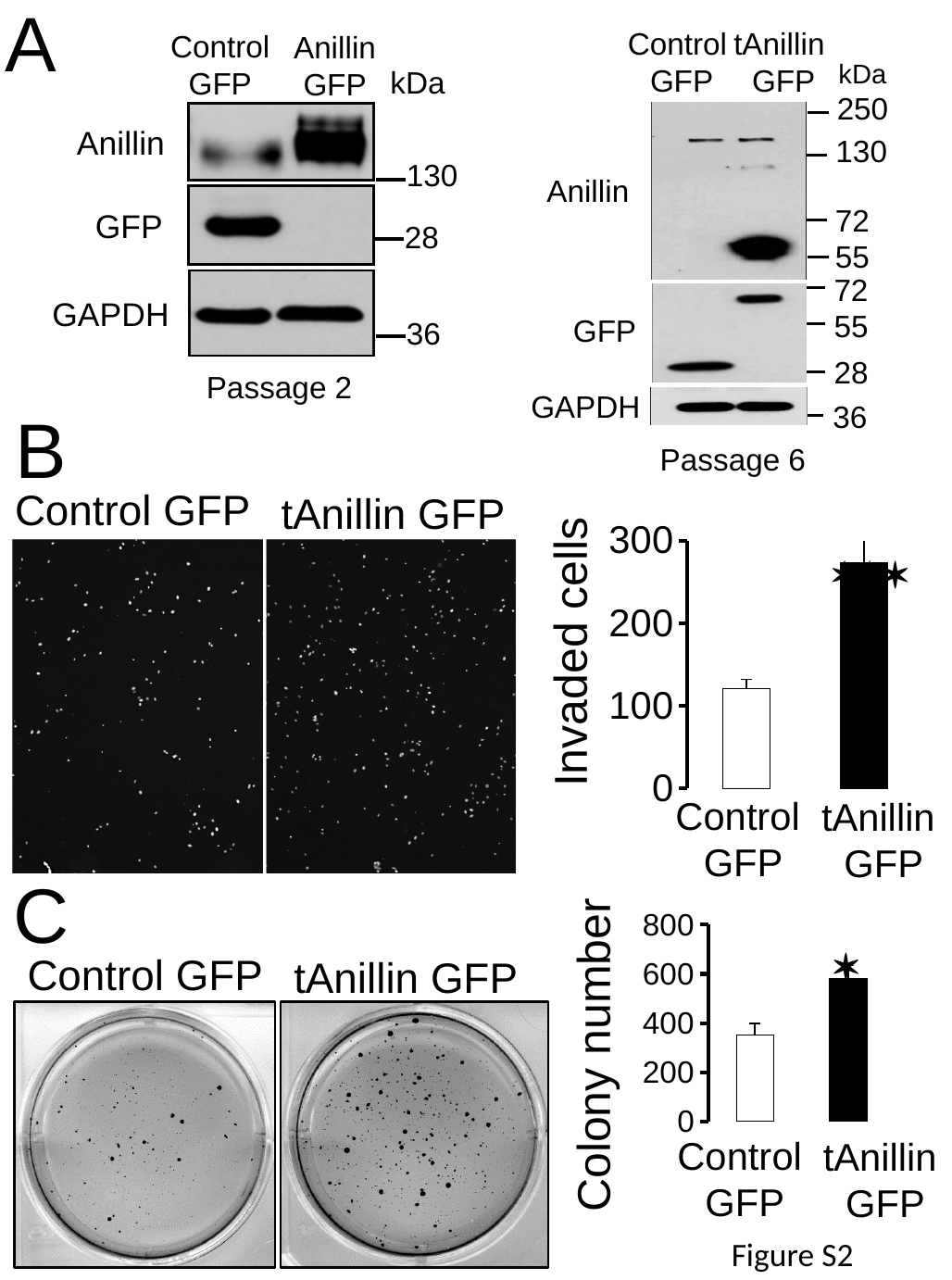
In the Colony number chart (panel C), is the value for Control GFP greater or less than 400? less In the Invaded cells chart (panel B), which category has the highest value? tAnillin GFP In the Invaded cells chart (panel B), what kind of chart is shown? bar chart In the Invaded cells chart (panel B), what is the label on the y axis? Invaded cells In the Colony number chart (panel C), which category has the highest value? tAnillin GFP In the Colony number chart (panel C), what is the highest tick value shown on the y axis? 800 In the Colony number chart (panel C), is the value for tAnillin GFP greater or less than 400? greater In the Invaded cells chart (panel B), which category has the lowest value? Control GFP In the Invaded cells chart (panel B), how many categories are plotted? 2 In the Colony number chart (panel C), is the value for Control GFP larger or smaller than the value for tAnillin GFP? smaller In the Invaded cells chart (panel B), is the value for Control GFP greater or less than 200? less